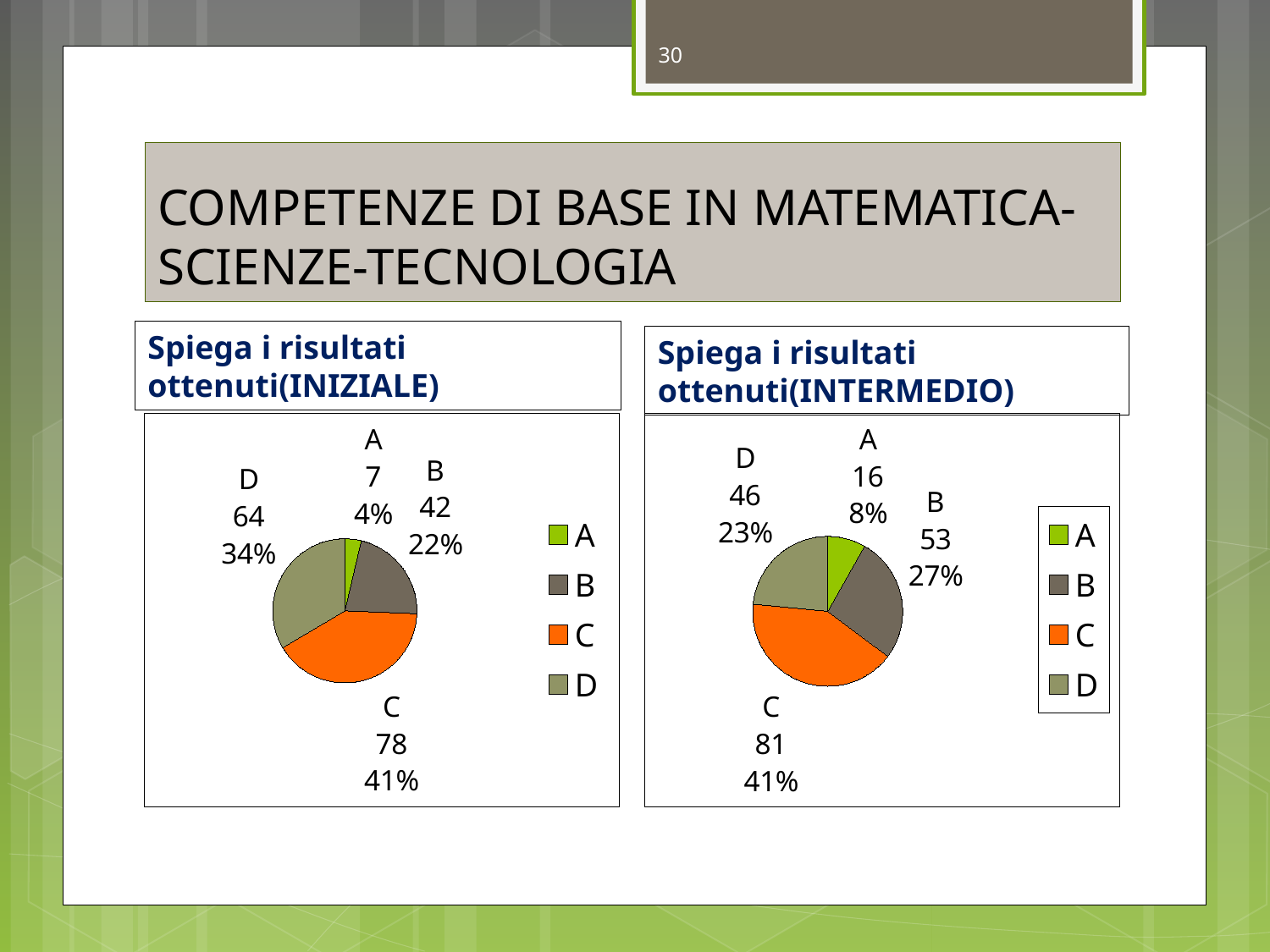
In the 'Spiega i risultati ottenuti(INTERMEDIO)' chart, what is the value for category D? 46 In the 'Spiega i risultati ottenuti(INIZIALE)' chart, what is the value for category C? 78 In the 'Spiega i risultati ottenuti(INTERMEDIO)' chart, what is the difference between the values for C and B? 28 In the 'Spiega i risultati ottenuti(INTERMEDIO)' chart, which is larger, the value for B or the value for D? B In the 'Spiega i risultati ottenuti(INIZIALE)' chart, what percentage share does category B have? 22% In the 'Spiega i risultati ottenuti(INIZIALE)' chart, what is the difference between the values for D and B? 22 In the 'Spiega i risultati ottenuti(INTERMEDIO)' chart, what percentage share does category A have? 8% How many categories does the 'Spiega i risultati ottenuti(INIZIALE)' chart show? 4 In the 'Spiega i risultati ottenuti(INIZIALE)' chart, which category has the largest value? C In the 'Spiega i risultati ottenuti(INIZIALE)' chart, what colour is the slice for category C? Orange What kind of chart is the 'Spiega i risultati ottenuti(INTERMEDIO)' chart? Pie chart In the 'Spiega i risultati ottenuti(INTERMEDIO)' chart, which category has the smallest value? A